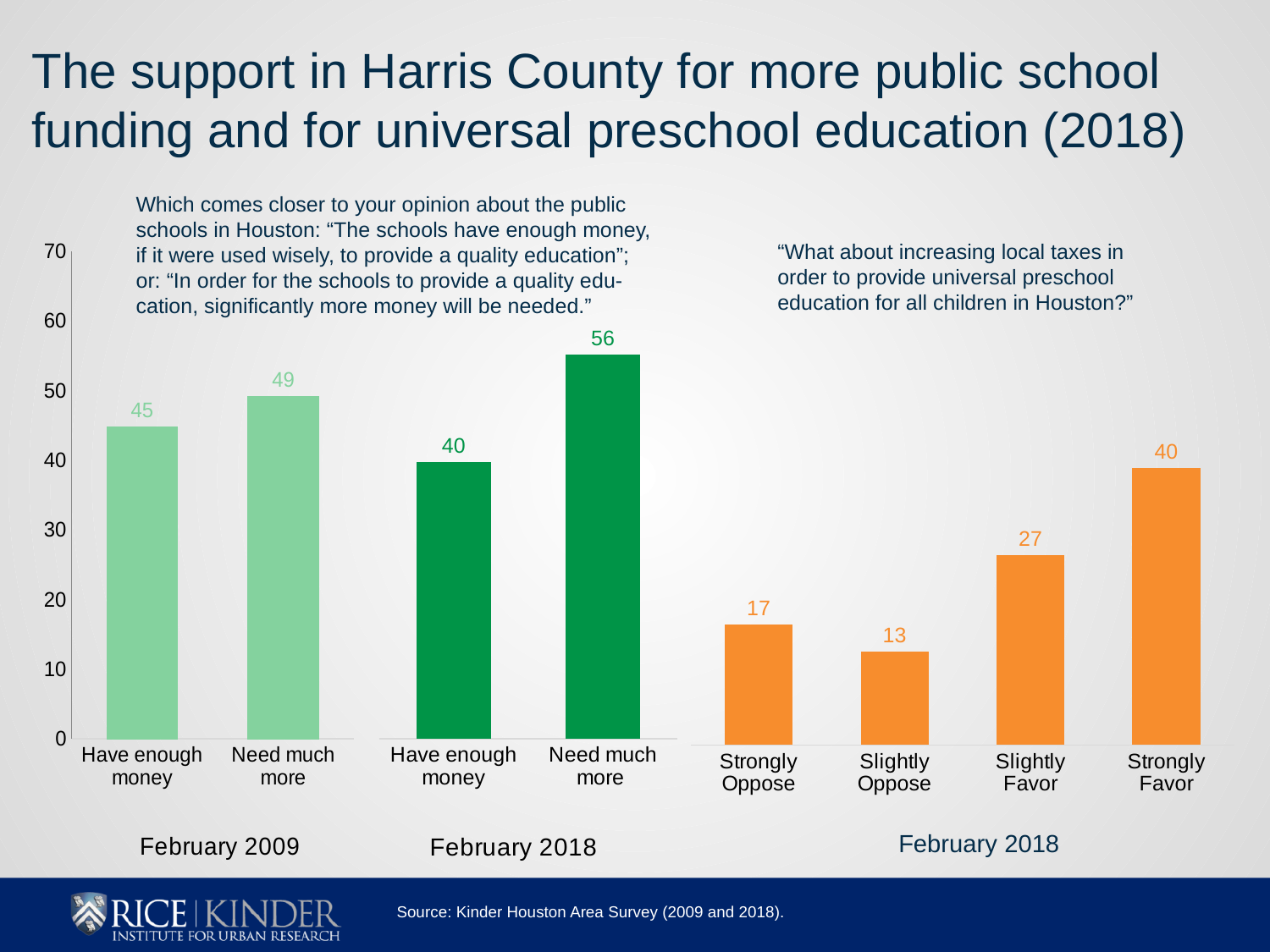
What value is shown for "Strongly Favor" on the universal preschool tax question? 40 What value is shown for "Have enough money" in February 2009? 45 Which response has the lowest value on the universal preschool tax question? Slightly Oppose What is the highest value shown on the vertical axis? 70 How many bars are shown for the universal preschool tax question? 4 Which is larger on the preschool tax question: "Slightly Favor" or "Strongly Oppose"? Slightly Favor What value is shown for "Slightly Oppose" on the universal preschool tax question? 13 What type of chart is shown on the slide? Bar chart What is the difference between "Need much more" and "Have enough money" in February 2018? 16 Which bar is the highest on the entire slide? Need much more (February 2018) What value is shown for "Need much more" in February 2018 on the public school funding question? 56 By how much did "Need much more" change from February 2009 to February 2018? 7